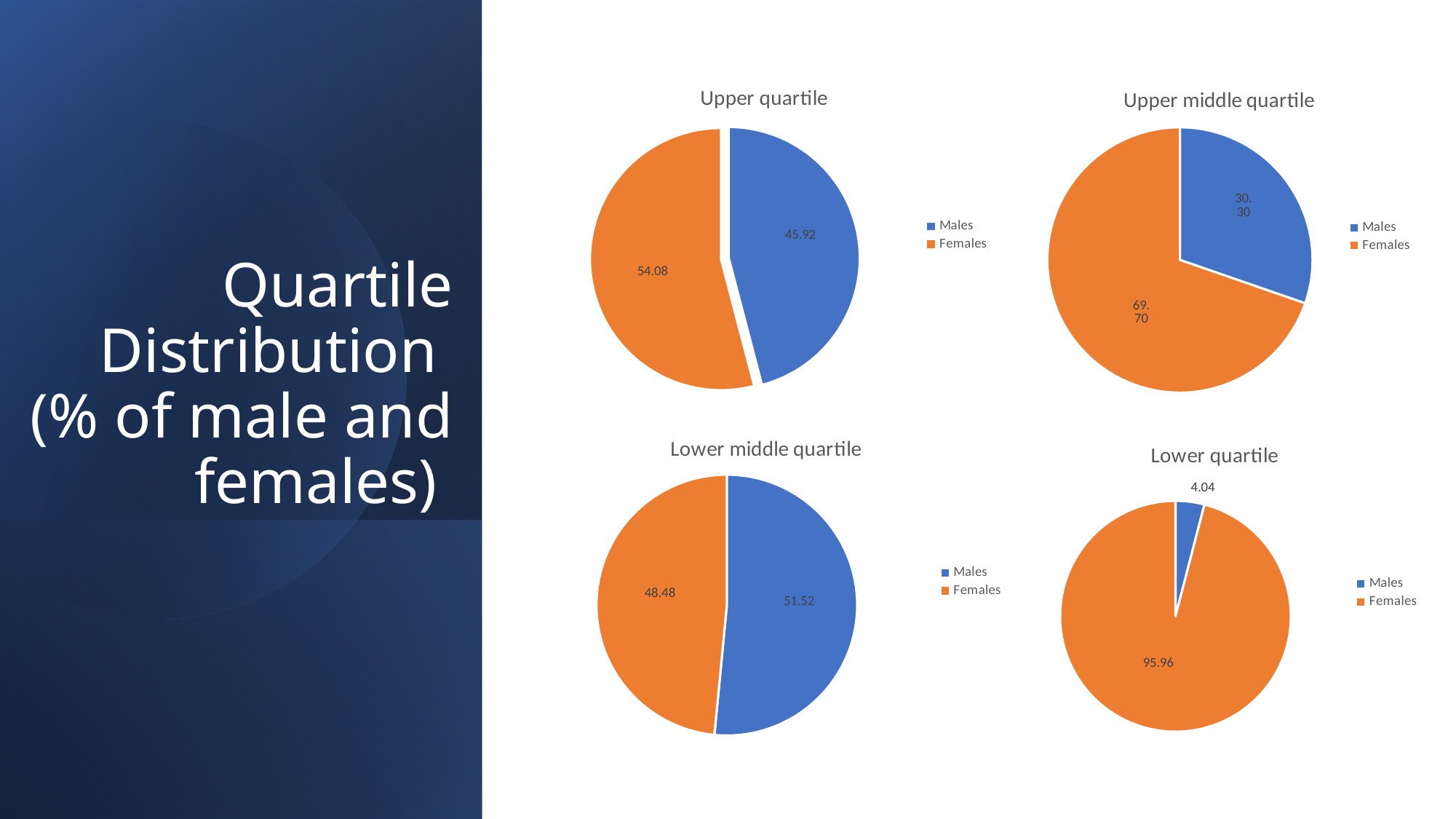
What kind of chart is the Lower quartile chart? Pie chart In the Upper quartile chart, what is the value for Females? 54.08 In the Lower quartile chart, what is the value for Females? 95.96 In the Lower middle quartile chart, which slice is larger, Males or Females? Males In the Upper quartile chart, what is the value for Males? 45.92 In the Upper middle quartile chart, what is the value for Females? 69.70 In the Lower quartile chart, what is the value for Males? 4.04 How many slices does the Upper quartile pie chart have? 2 In the Upper middle quartile chart, what is the difference between the Females and Males values? 39.40 How many entries does the legend of the Lower middle quartile chart list? 2 In the Lower middle quartile chart, what is the value for Males? 51.52 In the Upper middle quartile chart, what is the value for Males? 30.30